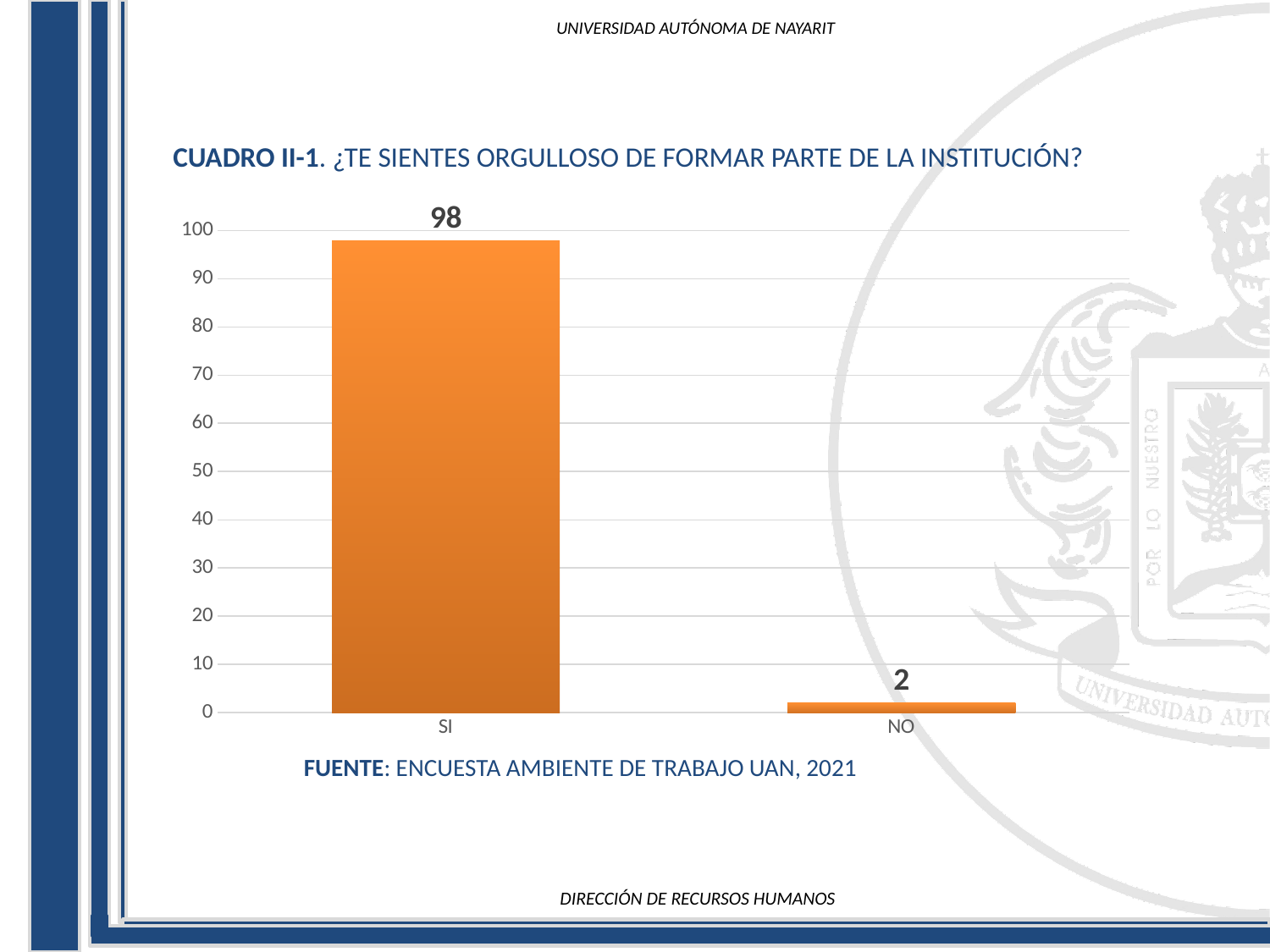
Which category has the lowest value? NO What kind of chart is shown on the slide? bar chart Is the value for NO greater or less than 10? less Which category has the highest value? SI What is the title of the chart? CUADRO II-1. ¿TE SIENTES ORGULLOSO DE FORMAR PARTE DE LA INSTITUCIÓN? What source is cited below the chart? ENCUESTA AMBIENTE DE TRABAJO UAN, 2021 Which is larger, the value for SI or the value for NO? SI Is the value for SI greater or less than 90? greater What is the difference between the values for SI and NO? 96 What is the value for SI? 98 What is the value for NO? 2 How many categories are shown on the x axis? 2